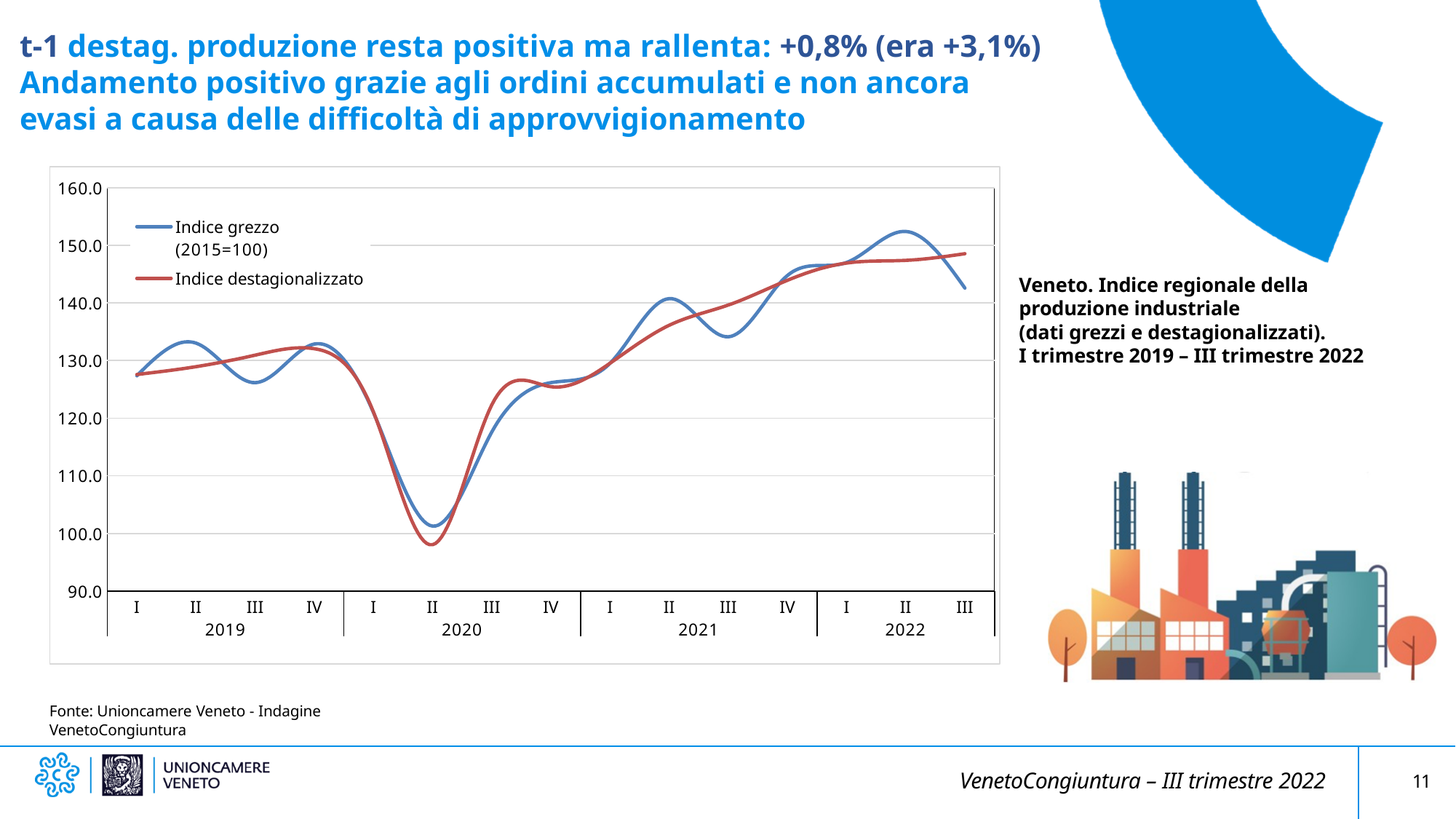
How many quarterly points are plotted along the x axis of the chart? 15 In which quarter does the Indice grezzo reach its highest value? II 2022 Does the Indice destagionalizzato rise or fall from II 2020 to II 2022? rise Which colour is used for the Indice destagionalizzato line? red In which quarter does the Indice grezzo reach its lowest value? II 2020 Is the value of the Indice grezzo in II 2020 greater or less than 110? less Is the value of the Indice grezzo in II 2022 greater or less than 150? greater Is the value of the Indice destagionalizzato in IV 2021 greater or less than 140? greater In III 2022, which series has the higher value, Indice grezzo or Indice destagionalizzato? Indice destagionalizzato How many series does the chart legend list? 2 What kind of chart is shown on the slide? line chart